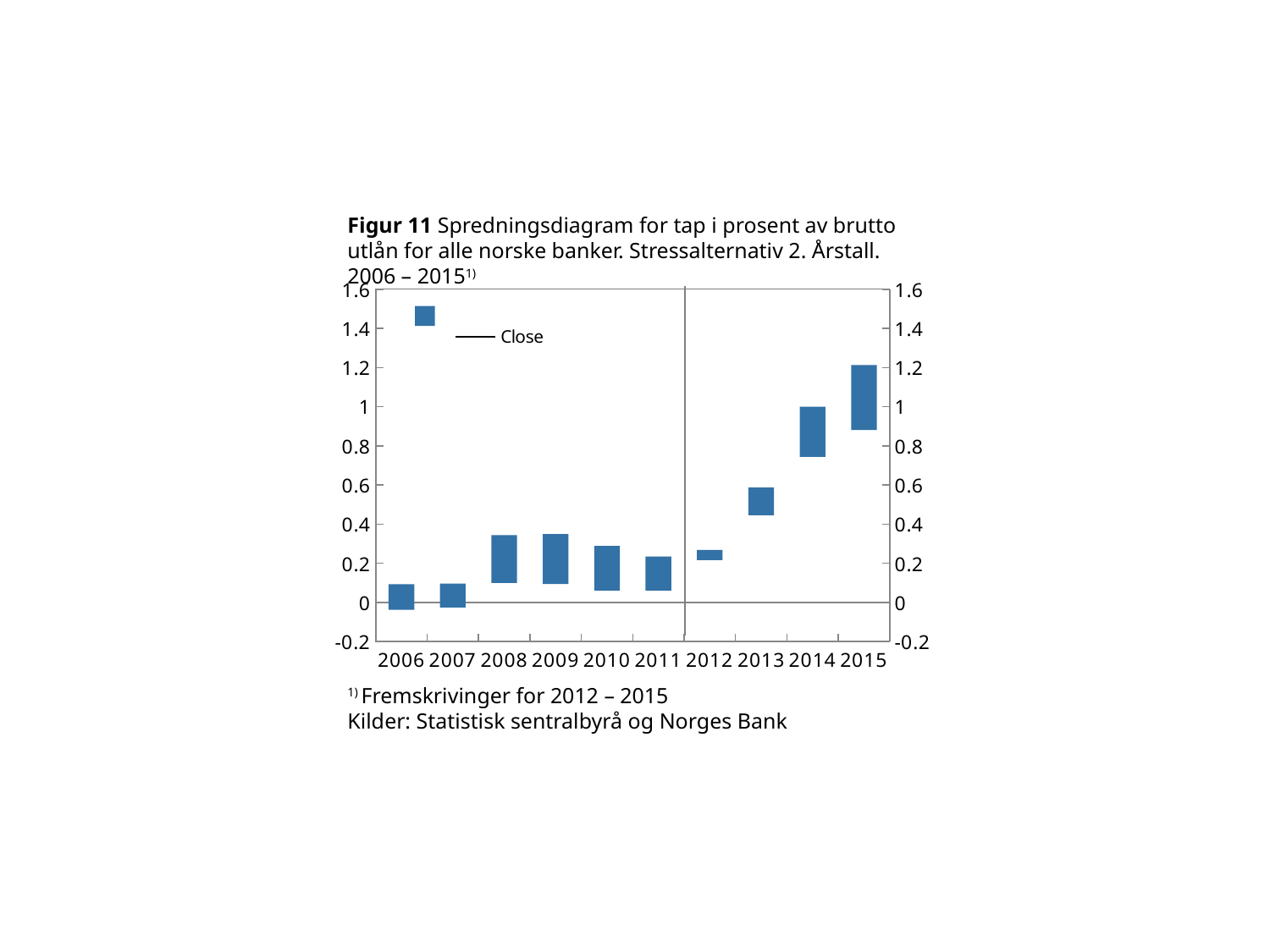
Which year has the highest bar in the chart? 2015 How many years are shown on the x axis of the chart? 10 Is the top of the bar for 2006 greater or less than 1.4? less What kind of chart is shown on the slide? bar chart What is the name of the series listed in the legend? Close How many series does the legend list? 1 Is the top of the bar for 2015 greater or less than 1? greater Do the bars rise or fall from 2012 to 2015? rise Which bar reaches higher, 2013 or 2014? 2014 Is the bar for 2012 greater or less than 0.4? less According to the footnote, which years are projections (fremskrivinger)? 2012 – 2015